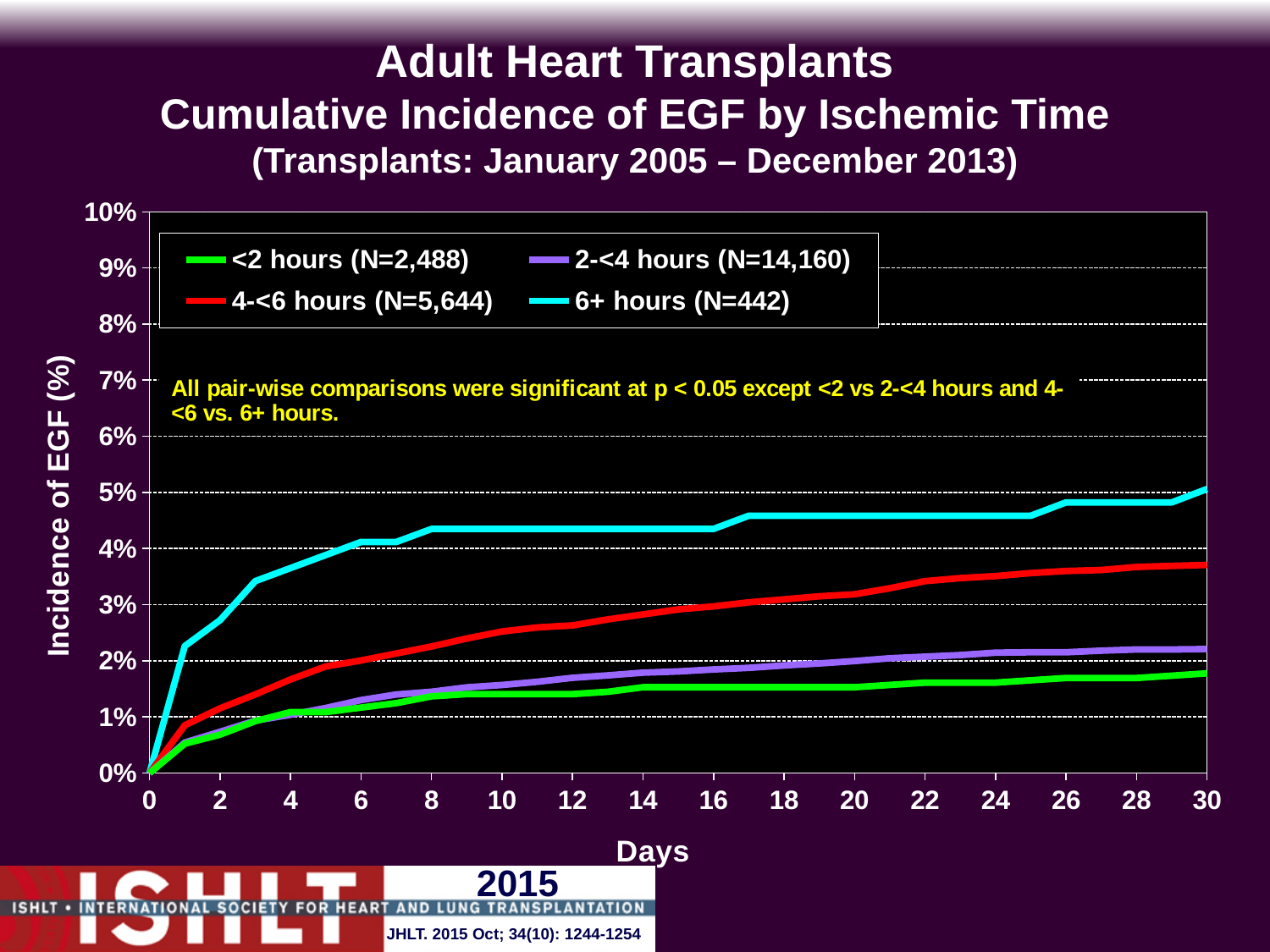
What kind of chart is shown on the slide? line chart Which ischemic time group has the lowest cumulative incidence of EGF at day 30? <2 hours (N=2,488) Is the value for the 4-<6 hours group at day 30 greater or less than 3%? greater How many series does the legend list? 4 Is the value for the <2 hours group at day 30 greater or less than 2%? less Do the cumulative incidence values rise or fall as days increase? rise At day 30, which is larger: the value for the 4-<6 hours group or the 2-<4 hours group? 4-<6 hours Is the value for the 6+ hours group at day 30 greater or less than 4%? greater Which ischemic time group has the highest cumulative incidence of EGF at day 30? 6+ hours (N=442) What is the N shown in the legend for the 2-<4 hours group? 14,160 What is the label of the y axis? Incidence of EGF (%)